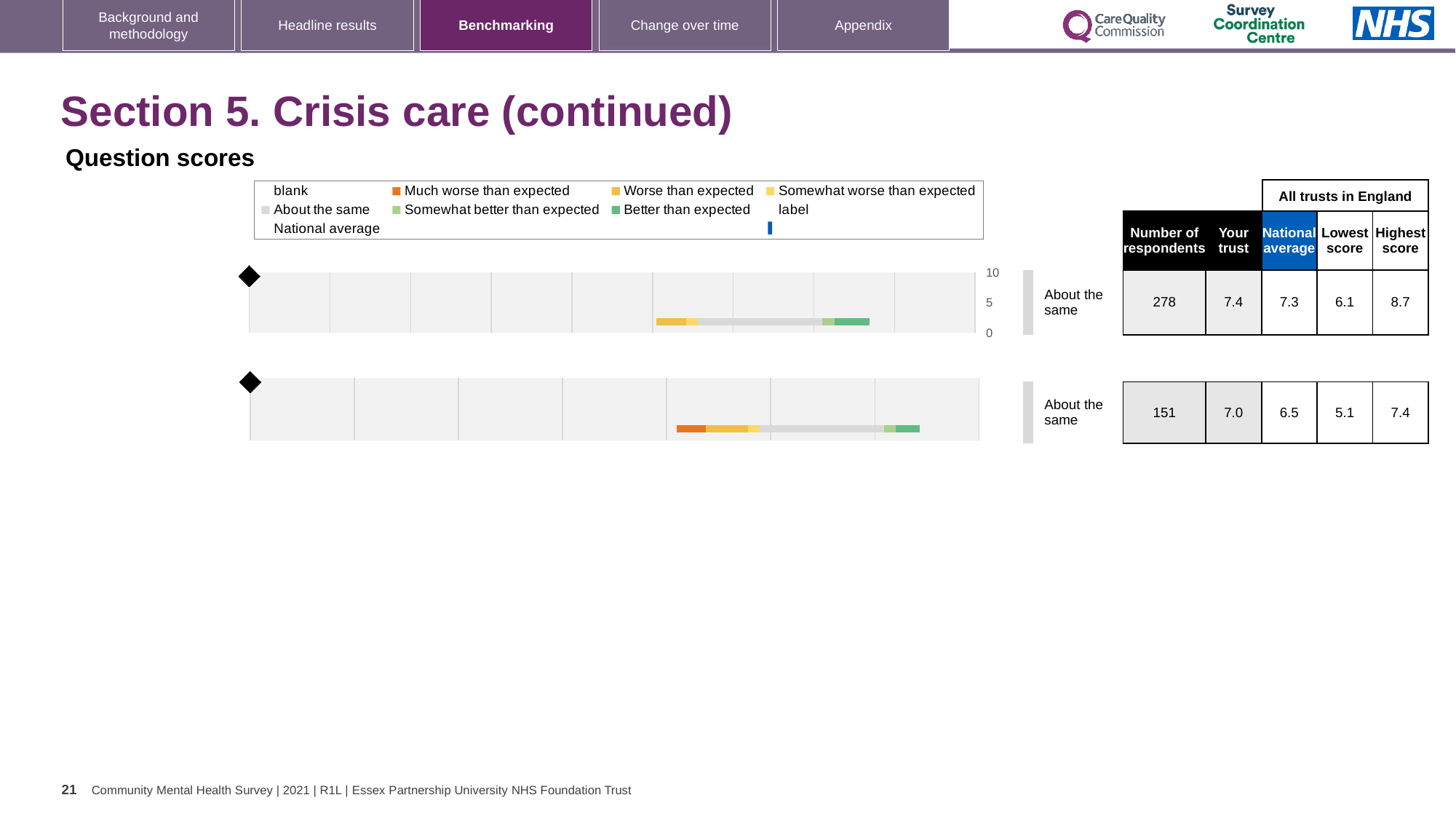
What is the maximum value shown on the score axis of the top chart? 10 For the top chart, how many respondents are listed in the accompanying table? 278 What benchmark category is given for the bottom chart? About the same For the bottom chart, what is the 'Your trust' score in the accompanying table? 7.0 In the legend, which colour represents 'Much worse than expected'? orange For the top chart, what is the difference between the highest score and the lowest score among all trusts in England? 2.6 For the top chart, what is the 'Your trust' score in the accompanying table? 7.4 For the top chart, what is the national average score in the accompanying table? 7.3 What kind of chart is used on the slide to show the question scores? bar chart For the bottom chart, what is the lowest score among all trusts in England? 5.1 For the bottom chart, which is larger: the 'Your trust' score or the national average? Your trust How many question score charts are shown on the slide? 2